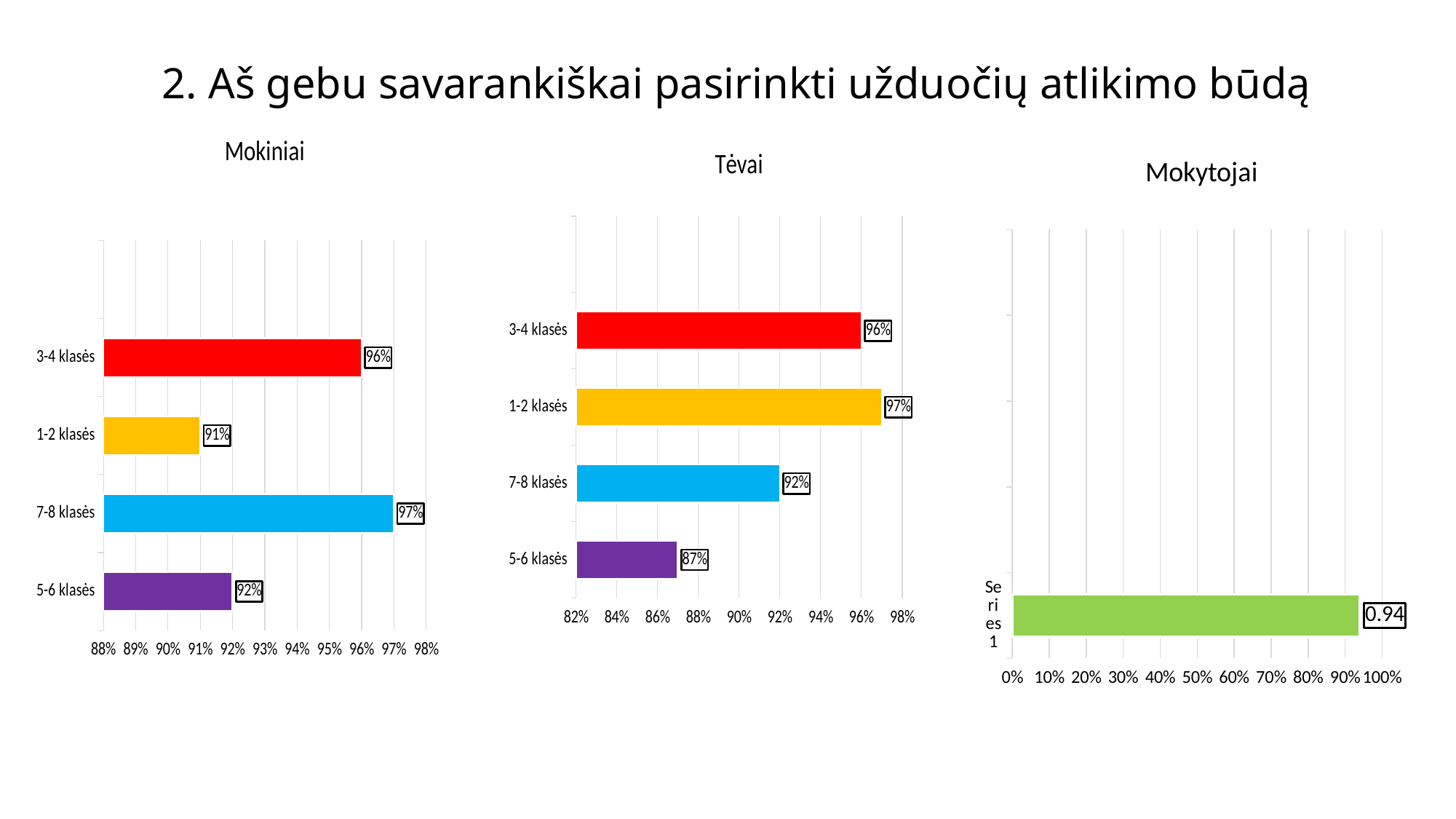
In the Mokiniai chart, which category has the highest value? 7-8 klasės How many categories are shown in the Tėvai chart? 4 In the Mokiniai chart, what is the difference between the values for 7-8 klasės and 1-2 klasės? 6% In the Mokiniai chart, which category has the lowest value? 1-2 klasės In the Tėvai chart, which is larger, the value for 3-4 klasės or 7-8 klasės? 3-4 klasės What kind of chart is the Mokiniai chart? bar chart In the Tėvai chart, what is the value for 5-6 klasės? 87% In the Mokytojai chart, what is the data label on the bar? 0.94 In the Tėvai chart, what is the difference between the values for 1-2 klasės and 5-6 klasės? 10% How many charts are on the slide? 3 In the Mokiniai chart, what is the value for 3-4 klasės? 96% In the Tėvai chart, which category has the highest value? 1-2 klasės